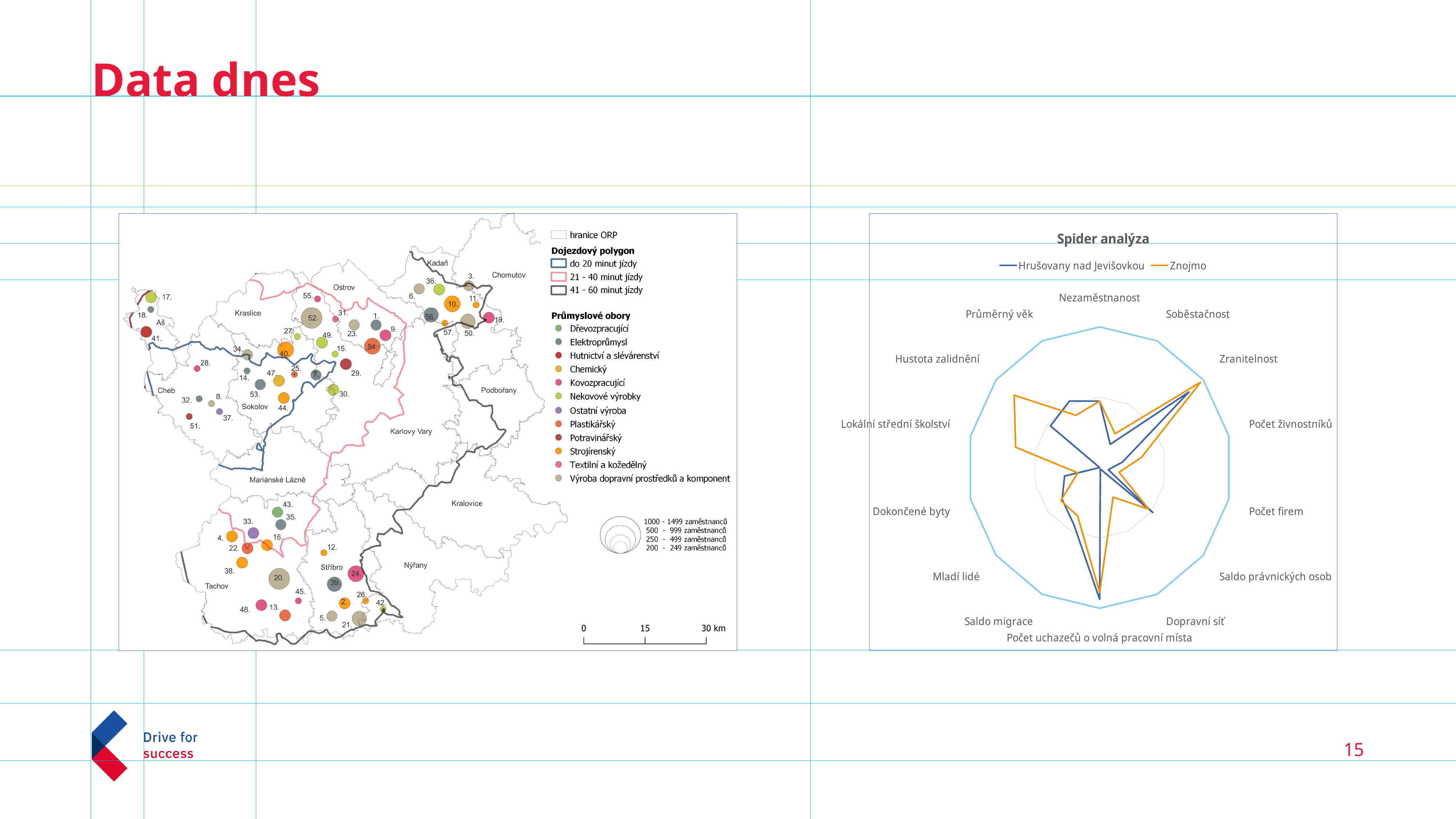
In the 'Spider analýza' chart, which series is drawn in orange? Znojmo On the map on the left, how many industrial sectors are listed under 'Průmyslové obory'? 12 Which two series are shown in the 'Spider analýza' chart? Hrušovany nad Jevišovkou and Znojmo What is the title of the chart on the right side of the slide? Spider analýza How many categories (axes) does the 'Spider analýza' radar chart have? 14 How many series does the legend of the 'Spider analýza' chart list? 2 On the map on the left, how many driving-time categories are listed under 'Dojezdový polygon'? 3 In the 'Spider analýza' chart, which series has the larger value for Lokální střední školství? Znojmo What kind of chart is the 'Spider analýza' chart? radar chart In the 'Spider analýza' chart, which series has the larger value for Hustota zalidnění? Znojmo On the map on the left, what is the maximum distance shown on the scale bar? 30 km